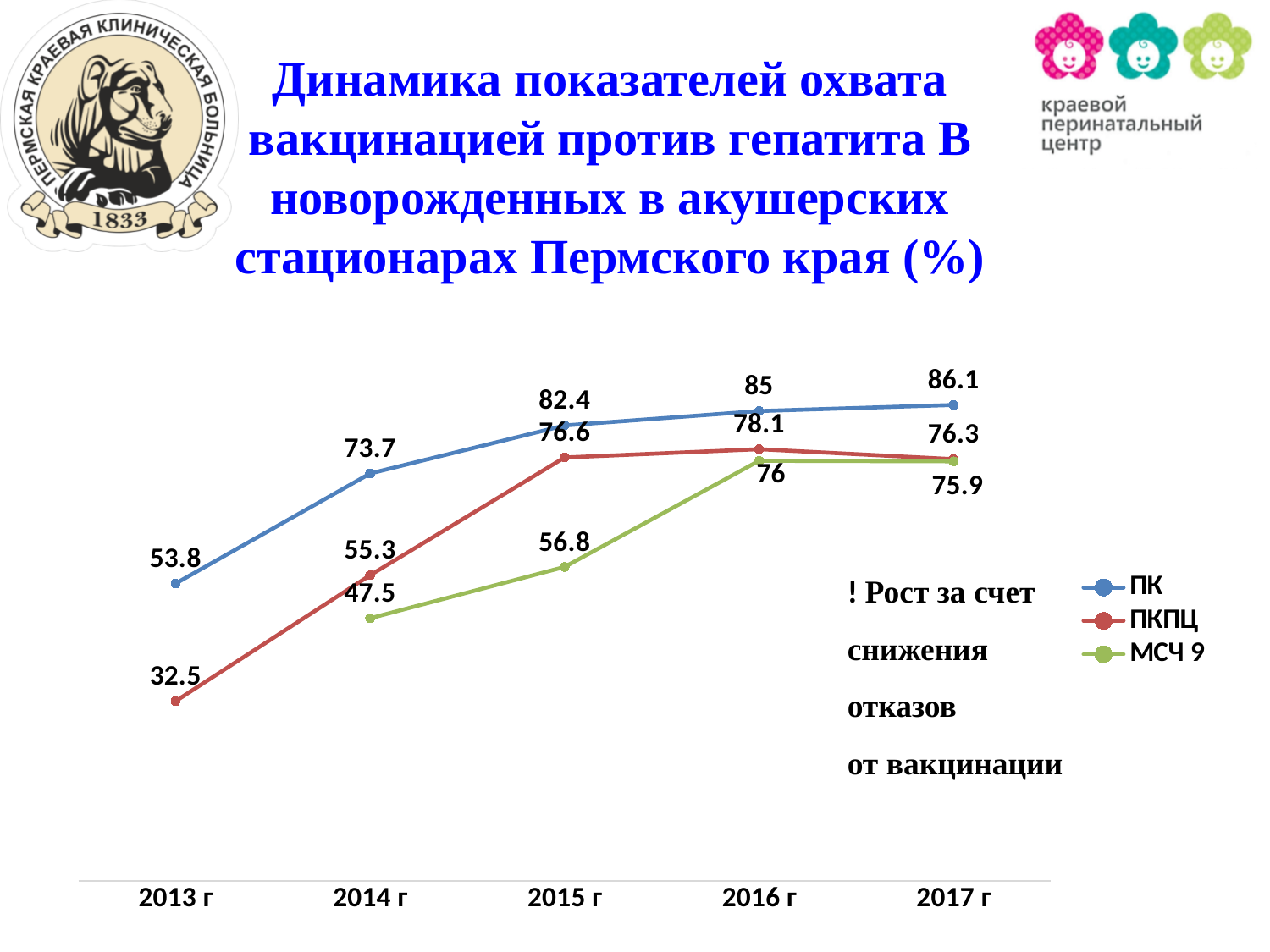
What is the value for ПКПЦ in 2013 г? 32.5 How many years are shown on the x axis? 5 How many series does the legend list? 3 What is the value for ПК in 2015 г? 82.4 What type of chart is shown on the slide? line chart Which is larger in 2016 г: the value for ПКПЦ or the value for МСЧ 9? ПКПЦ In which year is the ПК series at its highest? 2017 г What is the value for ПКПЦ in 2017 г? 76.3 Does the ПК series rise or fall from 2013 г to 2017 г? rise In which year is the ПКПЦ series at its lowest? 2013 г What is the value for МСЧ 9 in 2014 г? 47.5 What is the difference between the ПК value and the ПКПЦ value in 2013 г? 21.3